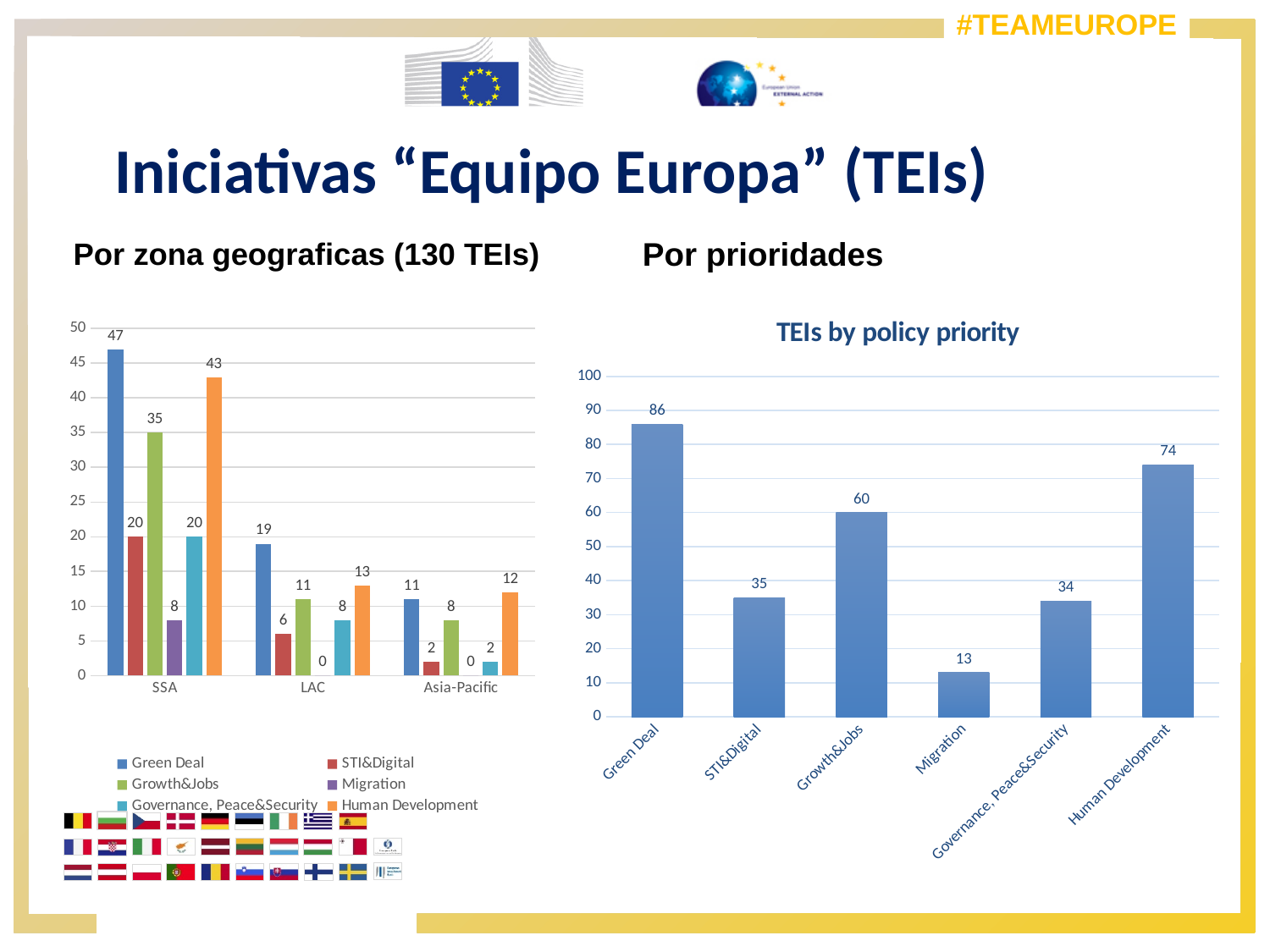
In the 'TEIs by policy priority' chart, which policy priority has the lowest value? Migration What type of chart is the 'TEIs by policy priority' chart on the right? Bar chart In the 'Por zona geograficas' chart on the left, what is the Green Deal value for SSA? 47 In the 'TEIs by policy priority' chart, what is the difference between Green Deal and Human Development? 12 In the 'Por zona geograficas' chart on the left, how many series does the legend list? 6 In the 'Por zona geograficas' chart on the left, what is the difference between the Green Deal values for SSA and LAC? 28 In the 'Por zona geograficas' chart on the left, which region has the highest Growth&Jobs value? SSA In the 'TEIs by policy priority' chart, what is the value for Green Deal? 86 In the 'Por zona geograficas' chart on the left, what is the Human Development value for LAC? 13 In the 'TEIs by policy priority' chart, what is the value for Governance, Peace&Security? 34 In the 'TEIs by policy priority' chart, which is larger: Growth&Jobs or STI&Digital? Growth&Jobs In the 'TEIs by policy priority' chart, how many policy priorities are shown on the x axis? 6